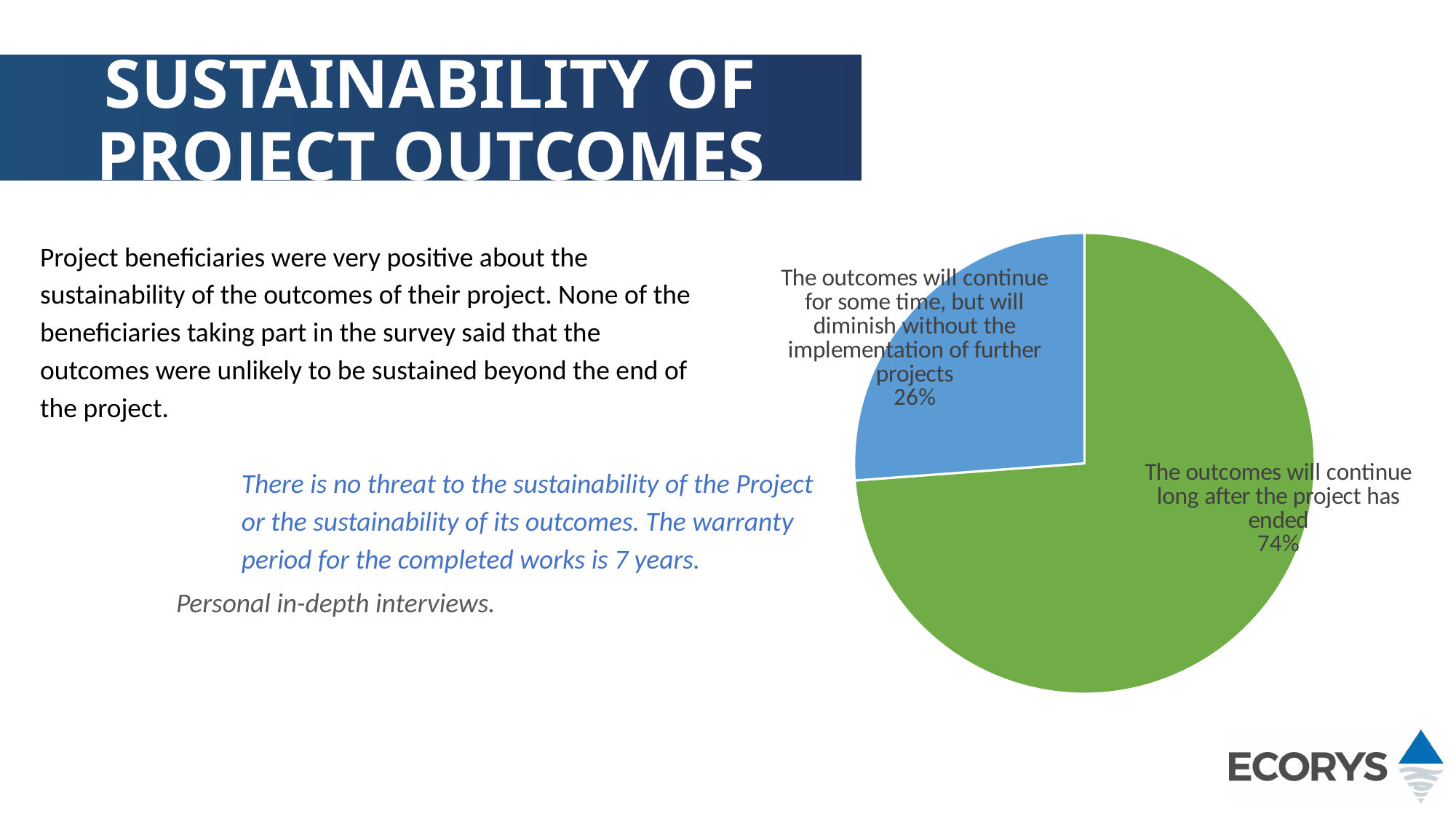
What is the difference in percentage points between the two slices of the pie chart? 48 What share of the pie is labelled 'The outcomes will continue long after the project has ended'? 74% What kind of chart is shown on the slide? pie chart Which slice of the pie chart is the largest? The outcomes will continue long after the project has ended Which slice of the pie chart is the smallest? The outcomes will continue for some time, but will diminish without the implementation of further projects What colour is the slice for 'The outcomes will continue long after the project has ended'? green Is the share for 'The outcomes will continue long after the project has ended' greater or less than 50%? greater Which is larger: the share for outcomes continuing long after the project has ended, or the share for outcomes that will diminish without further projects? The outcomes will continue long after the project has ended What colour is the slice for 'The outcomes will continue for some time, but will diminish without the implementation of further projects'? blue How many slices does the pie chart have? 2 What share of the pie is labelled 'The outcomes will continue for some time, but will diminish without the implementation of further projects'? 26%